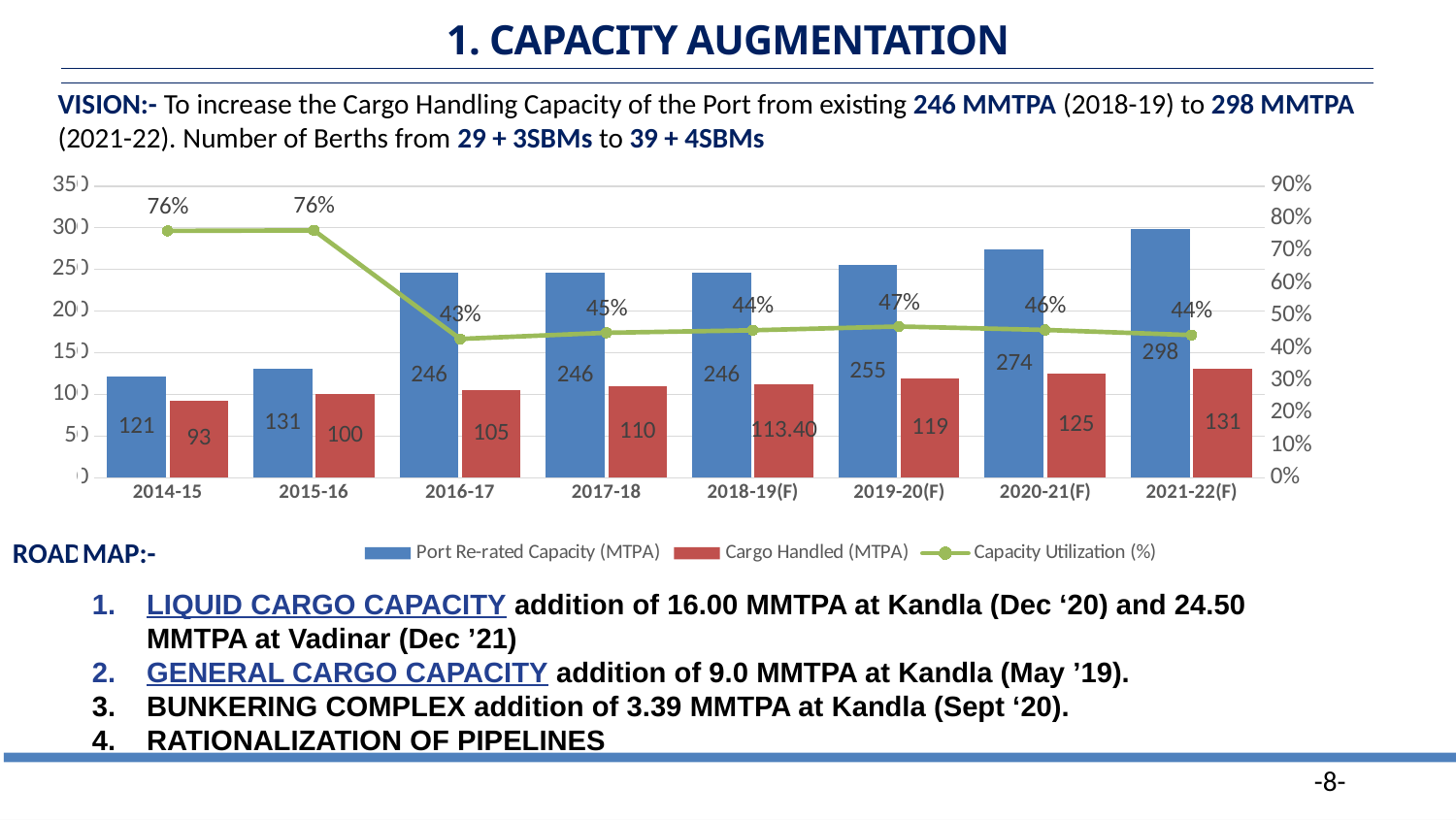
Which year has the highest Port Re-rated Capacity (MTPA)? 2021-22(F) How many years are shown on the x axis of the chart? 8 What is the Port Re-rated Capacity (MTPA) for 2021-22(F)? 298 Which series in the chart is plotted as a line? Capacity Utilization (%) What is the Capacity Utilization (%) for 2019-20(F)? 47% How many series does the chart legend list? 3 Which year has the lowest Cargo Handled (MTPA) value? 2014-15 What kind of chart is shown on the slide? Combined bar and line chart Does the Cargo Handled (MTPA) series rise or fall from 2014-15 to 2021-22(F)? Rise What is the Cargo Handled (MTPA) value for 2018-19(F)? 113.40 Which is larger: Cargo Handled in 2017-18 or Cargo Handled in 2015-16? 2017-18 What is the difference between Port Re-rated Capacity and Cargo Handled in 2020-21(F)? 149